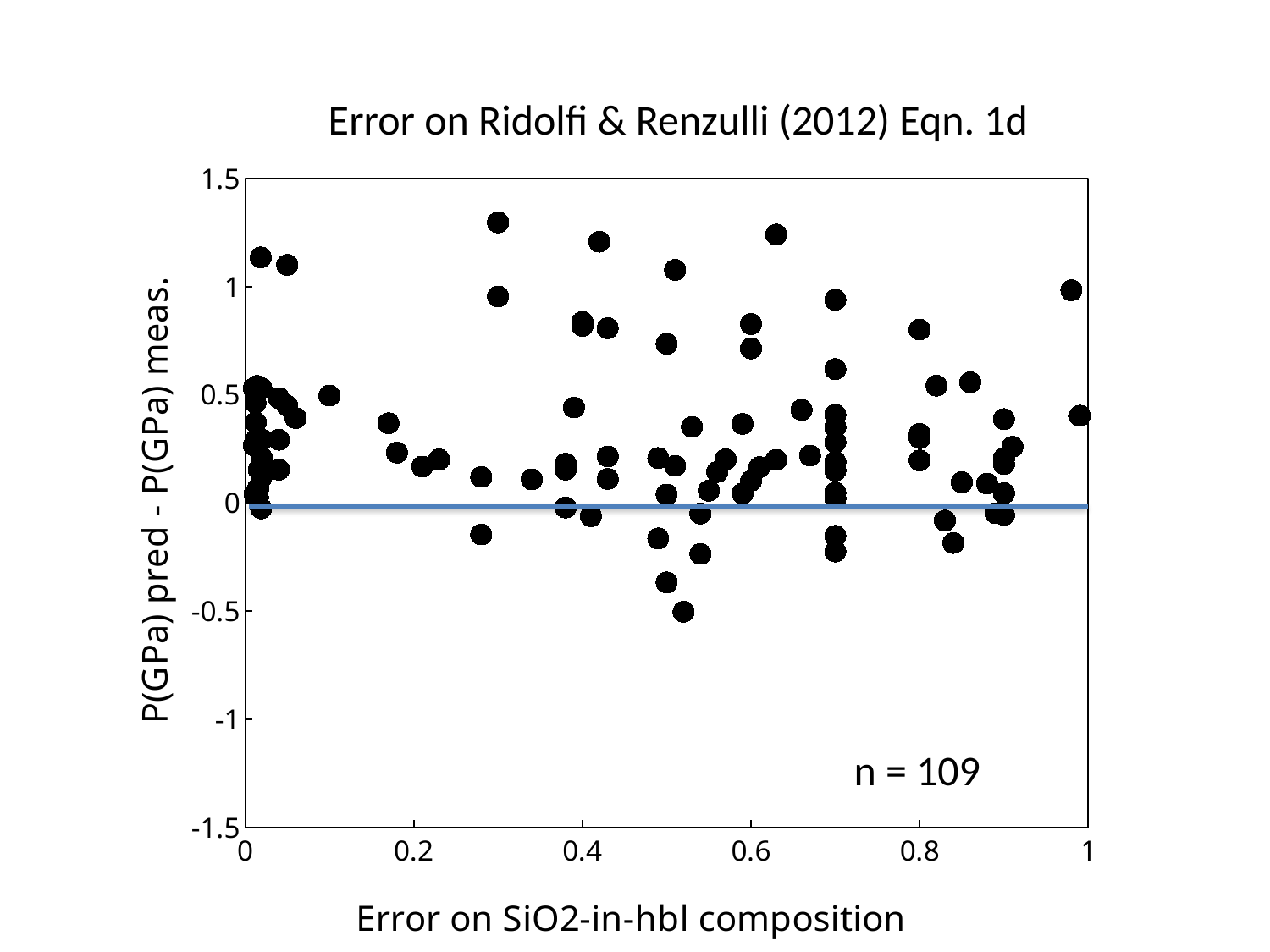
Is the highest plotted point greater or less than 1 on the y axis? greater What is the label of the x axis? Error on SiO2-in-hbl composition Is the highest plotted point greater or less than 1.5 on the y axis? less What is the title of the chart? Error on Ridolfi & Renzulli (2012) Eqn. 1d Are most of the plotted points above or below the horizontal line at 0? above How many data points does the chart state it contains (n)? 109 What kind of chart is shown on the slide? scatter plot Is the lowest plotted point greater or less than -0.25 on the y axis? less